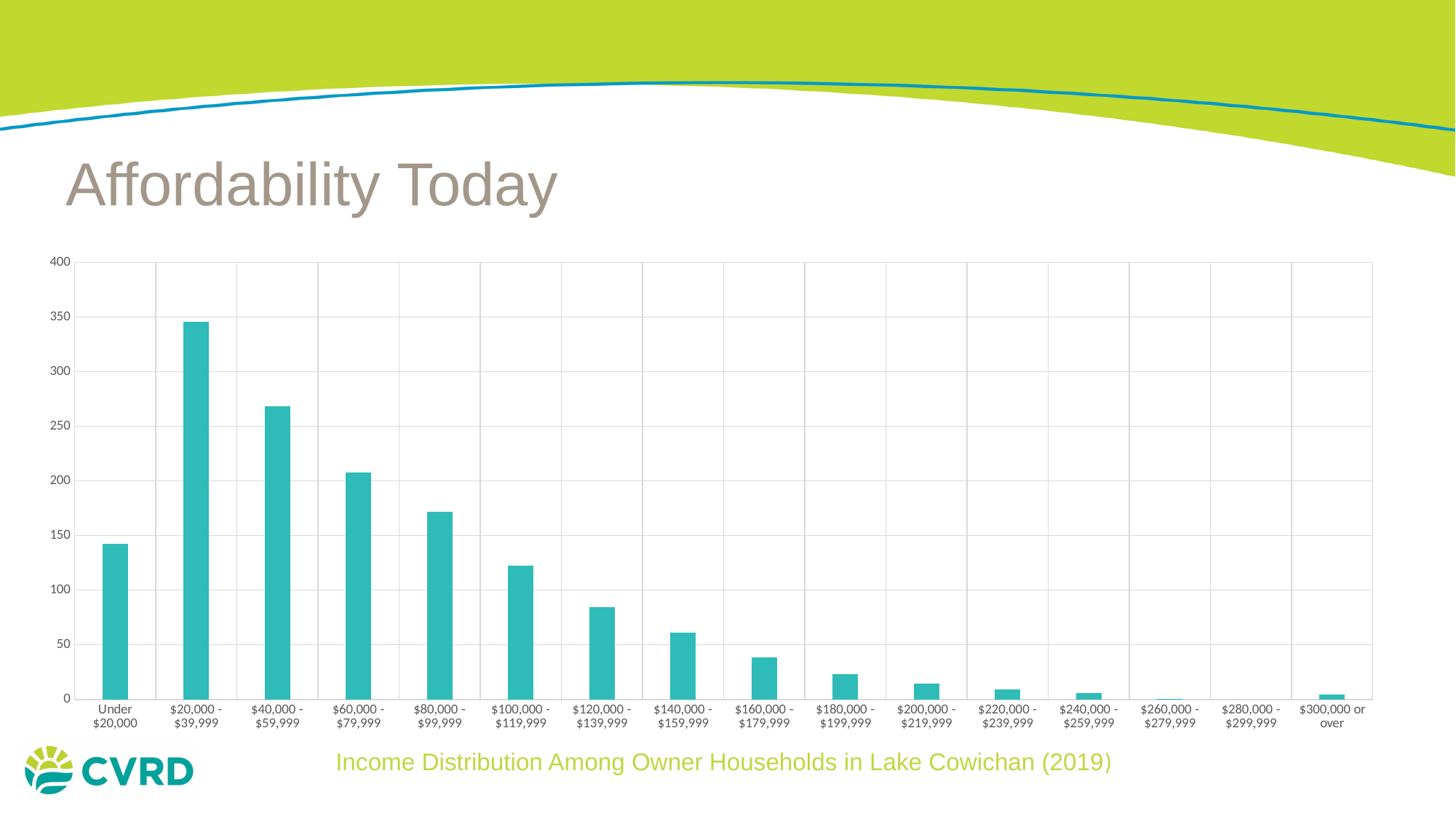
From the $20,000 - $39,999 category onward, do the values rise or fall as income increases? fall What kind of chart is shown on the slide? bar chart What is the caption of the chart shown below the bars? Income Distribution Among Owner Households in Lake Cowichan (2019) Is the value for $160,000 - $179,999 greater or less than 50? less How many income categories are shown on the x axis? 16 Is the value for Under $20,000 greater or less than 150? less Which income category has the highest number of owner households? $20,000 - $39,999 Is the value for $120,000 - $139,999 greater or less than 100? less Which is larger, the value for $40,000 - $59,999 or the value for $60,000 - $79,999? $40,000 - $59,999